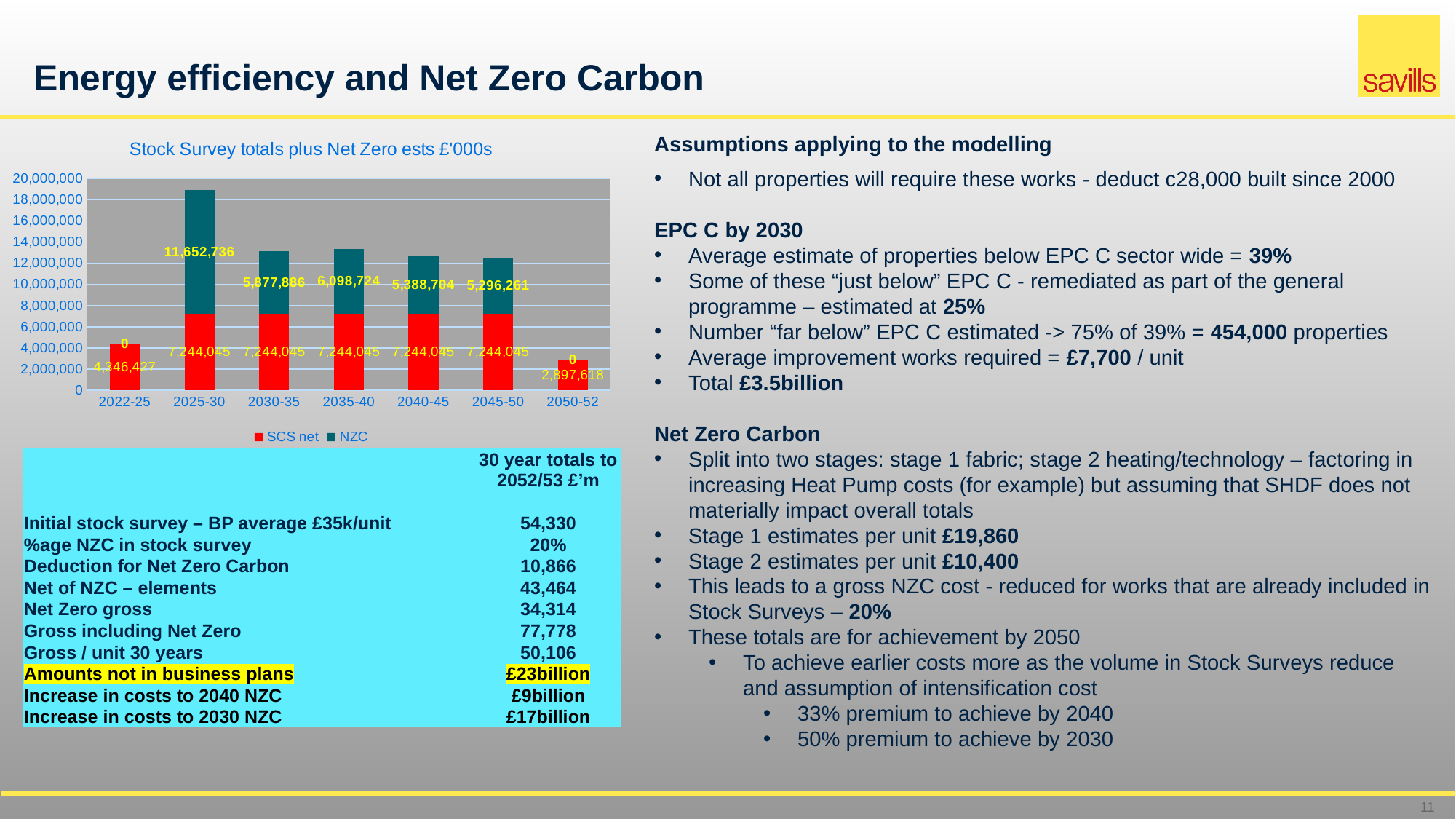
What type of chart is shown on the slide? Stacked bar chart Which is larger, the NZC value for 2040-45 or for 2045-50? 2040-45 What is the total stacked value for 2025-30? 18,896,781 What is the difference between the NZC values for 2035-40 and 2030-35? 220,838 What is the SCS net value for 2022-25? 4,346,427 Which period has the highest NZC value? 2025-30 What is the title of the chart? Stock Survey totals plus Net Zero ests £'000s What is the NZC value for 2025-30? 11,652,736 How many series does the chart legend list? 2 Which period has the lowest SCS net value? 2050-52 What is the SCS net value for 2050-52? 2,897,618 How many period categories are shown on the x axis of the chart? 7